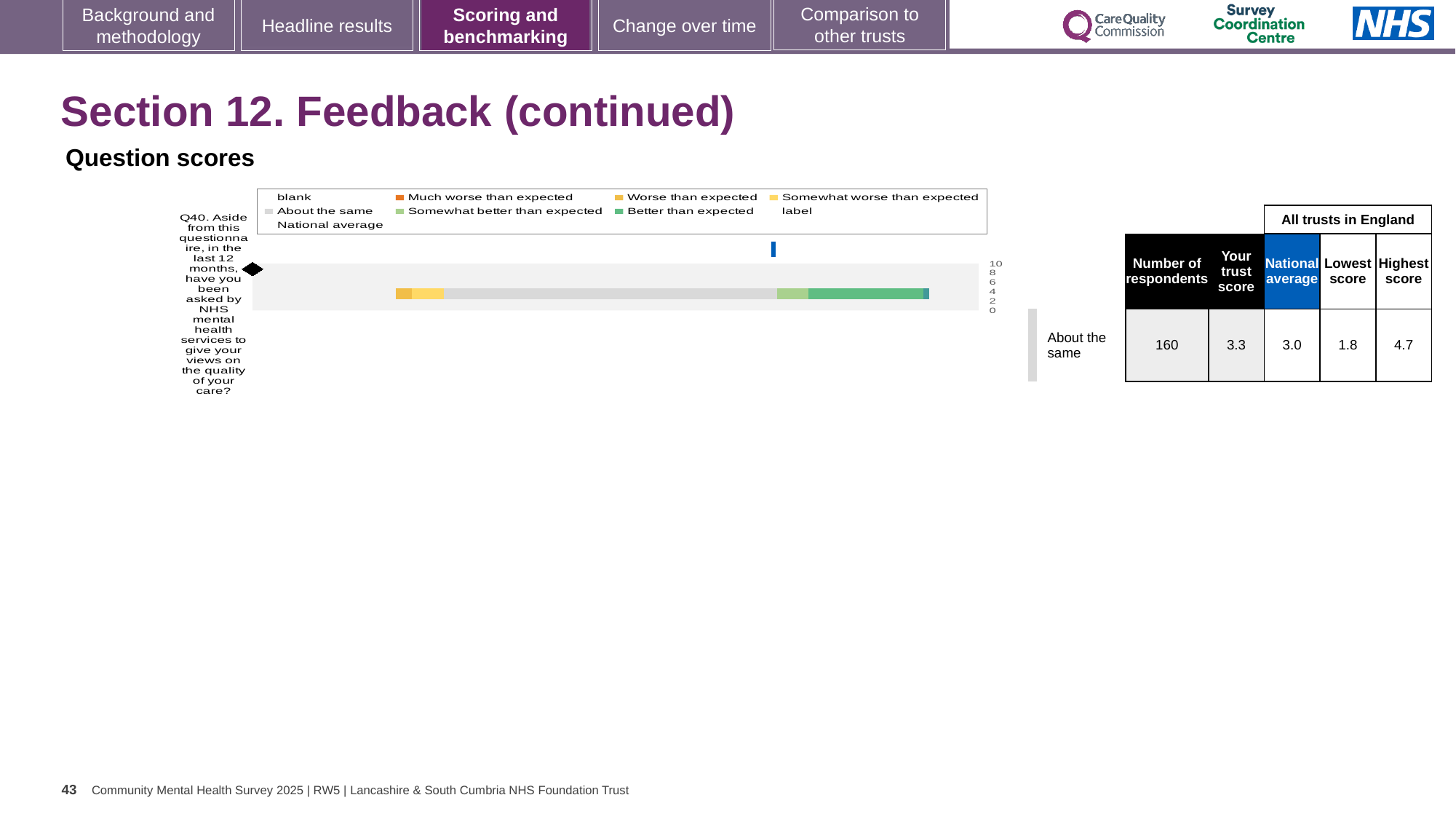
Is the trust's score for Q40 higher or lower than the national average? higher What is the national average score for Q40 according to the table? 3.0 How many respondents answered Q40? 160 What is the difference between the highest and lowest scores for Q40 across all trusts in England? 2.9 Which question is plotted in the chart? Q40. Aside from this questionnaire, in the last 12 months, have you been asked by NHS mental health services to give your views on the quality of your care? What colour is used in the legend for 'Better than expected'? green What is the lowest score among all trusts in England for Q40? 1.8 What is the trust's score for Q40 according to the table? 3.3 Which benchmark category does the trust's result for Q40 fall into? About the same How many questions (categories) are plotted in the chart? 1 What kind of chart is shown on the slide for Q40? bar chart What is the highest score among all trusts in England for Q40? 4.7